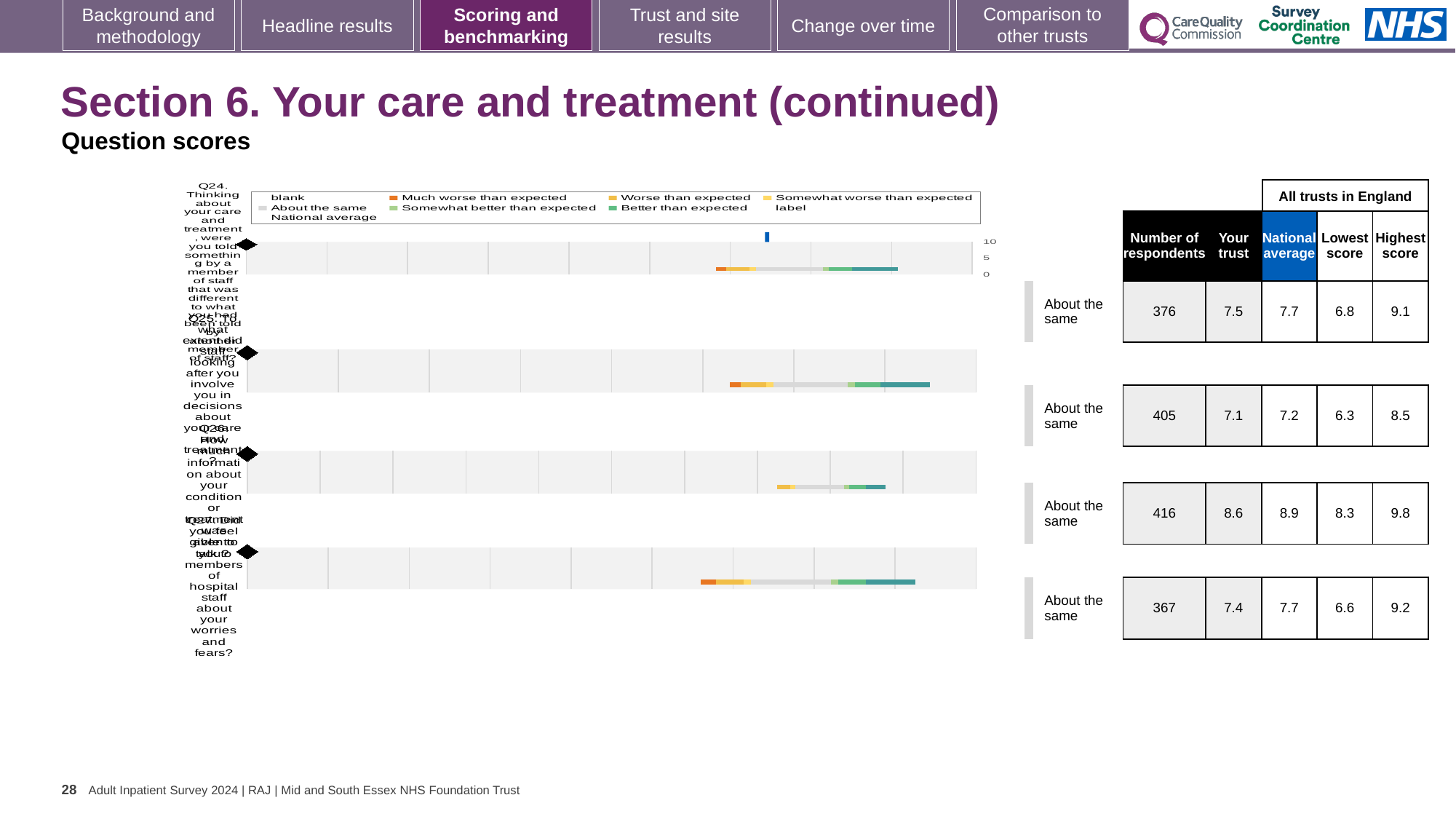
Is the 'Your trust' score for Q26 larger or smaller than the 'Your trust' score for Q25? larger What type of chart is used to show the question scores on this slide? bar chart What is the difference between the highest score and the lowest score for Q24? 2.3 What is the highest value shown on the score axis of the Q24 chart? 10 How many question charts (Q24 to Q27) are shown on the slide? 4 Which question has the lowest 'Your trust' score? Q25 Which colour in the legend represents 'Much worse than expected'? orange What benchmark category is the trust placed in for Q27? About the same What is the national average score for Q26 (how much information about your condition or treatment was given to you)? 8.9 What is the 'Your trust' score for Q24 (told something different by another member of staff)? 7.5 How many respondents answered Q27 (feeling able to talk to hospital staff about worries and fears)? 367 Which question has the highest 'Your trust' score? Q26